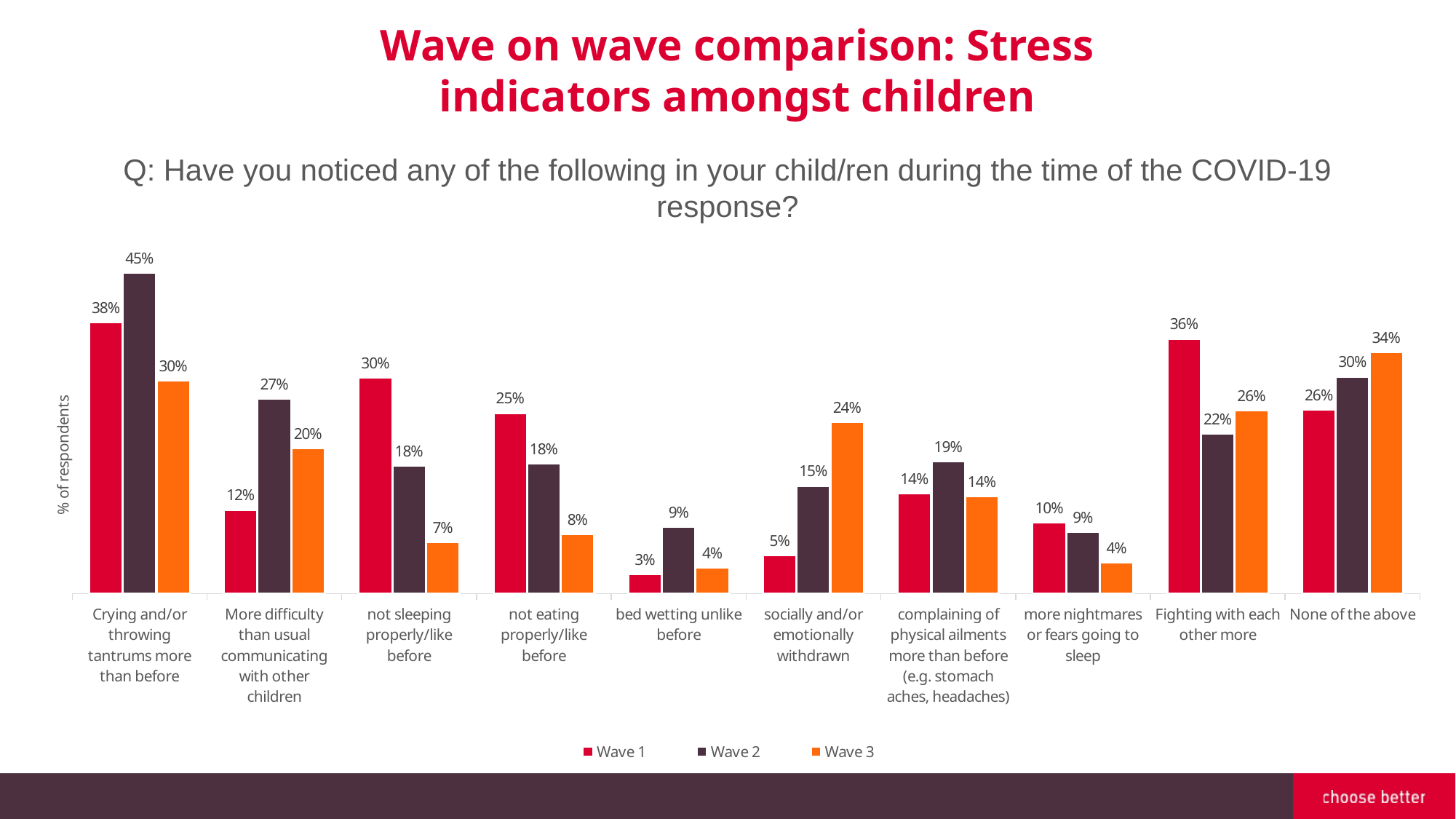
What is the Wave 3 value for 'not sleeping properly/like before'? 7% What is the difference between the Wave 2 and Wave 1 values for 'More difficulty than usual communicating with other children'? 15% For 'socially and/or emotionally withdrawn', which wave has the larger value, Wave 1 or Wave 3? Wave 3 What is the Wave 2 value for 'Crying and/or throwing tantrums more than before'? 45% Which category has the lowest Wave 1 value? bed wetting unlike before What kind of chart is shown on the slide? Bar chart How many series does the legend list? 3 How many categories are shown on the x axis? 10 Which category has the highest Wave 3 value? None of the above What is the difference between the Wave 1 and Wave 3 values for 'not sleeping properly/like before'? 23% What is the label on the vertical axis of the chart? % of respondents What is the Wave 1 value for 'Fighting with each other more'? 36%